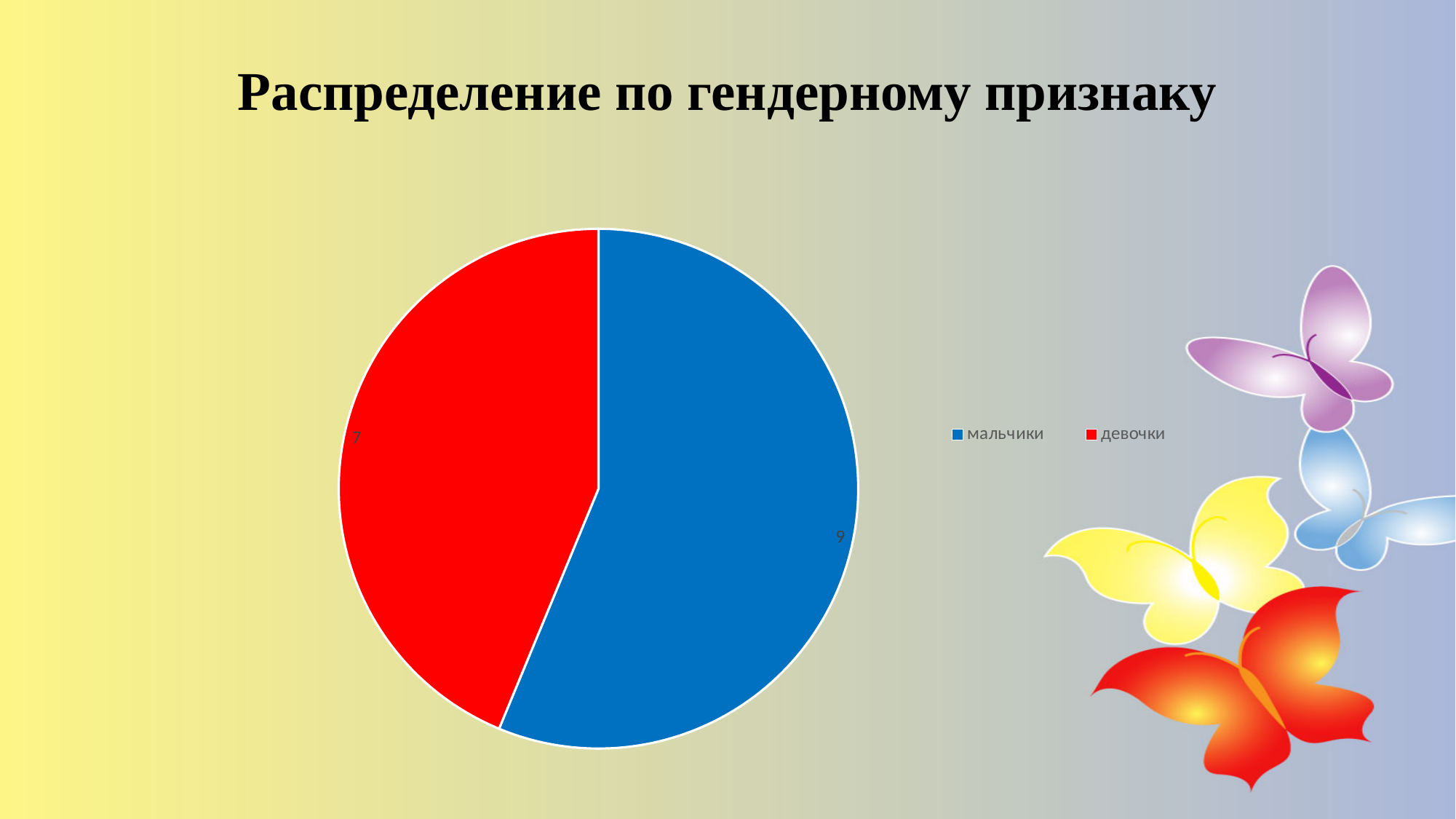
What is the value for девочки? 7 How many slices does the pie chart have? 2 How many entries does the legend list? 2 Which is larger, the value for мальчики or the value for девочки? мальчики What is the total of all slices in the pie chart? 16 What is the value for мальчики? 9 What colour is the slice for девочки? red What kind of chart is shown on the slide? pie chart What is the title of the slide? Распределение по гендерному признаку Which category has the largest slice? мальчики What is the difference between the values for мальчики and девочки? 2 Which category has the smallest slice? девочки